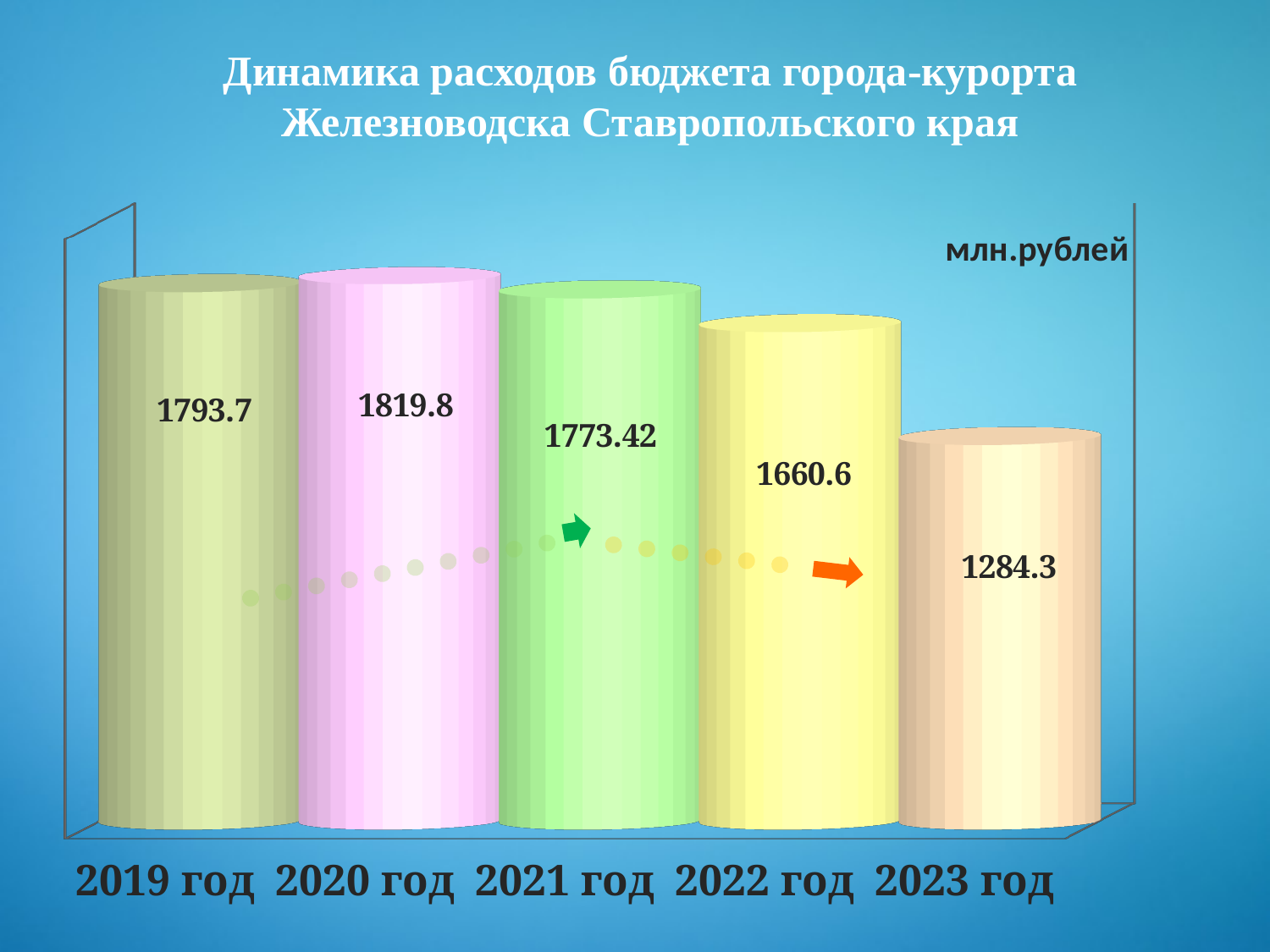
What is the difference between the values for 2022 год and 2023 год? 376.3 Which year has the lowest value? 2023 год What kind of chart is shown on the slide? Bar chart What is the budget expenditure value shown for 2020 год? 1819.8 Which year has the highest value? 2020 год What value is shown for 2023 год? 1284.3 What unit of measurement is indicated on the chart? млн.рублей What value is shown for 2021 год? 1773.42 Do the values rise or fall from 2020 год to 2023 год? Fall What is the difference between the values for 2020 год and 2019 год? 26.1 How many years are shown on the chart? 5 Which is larger, the value for 2019 год or the value for 2022 год? 2019 год